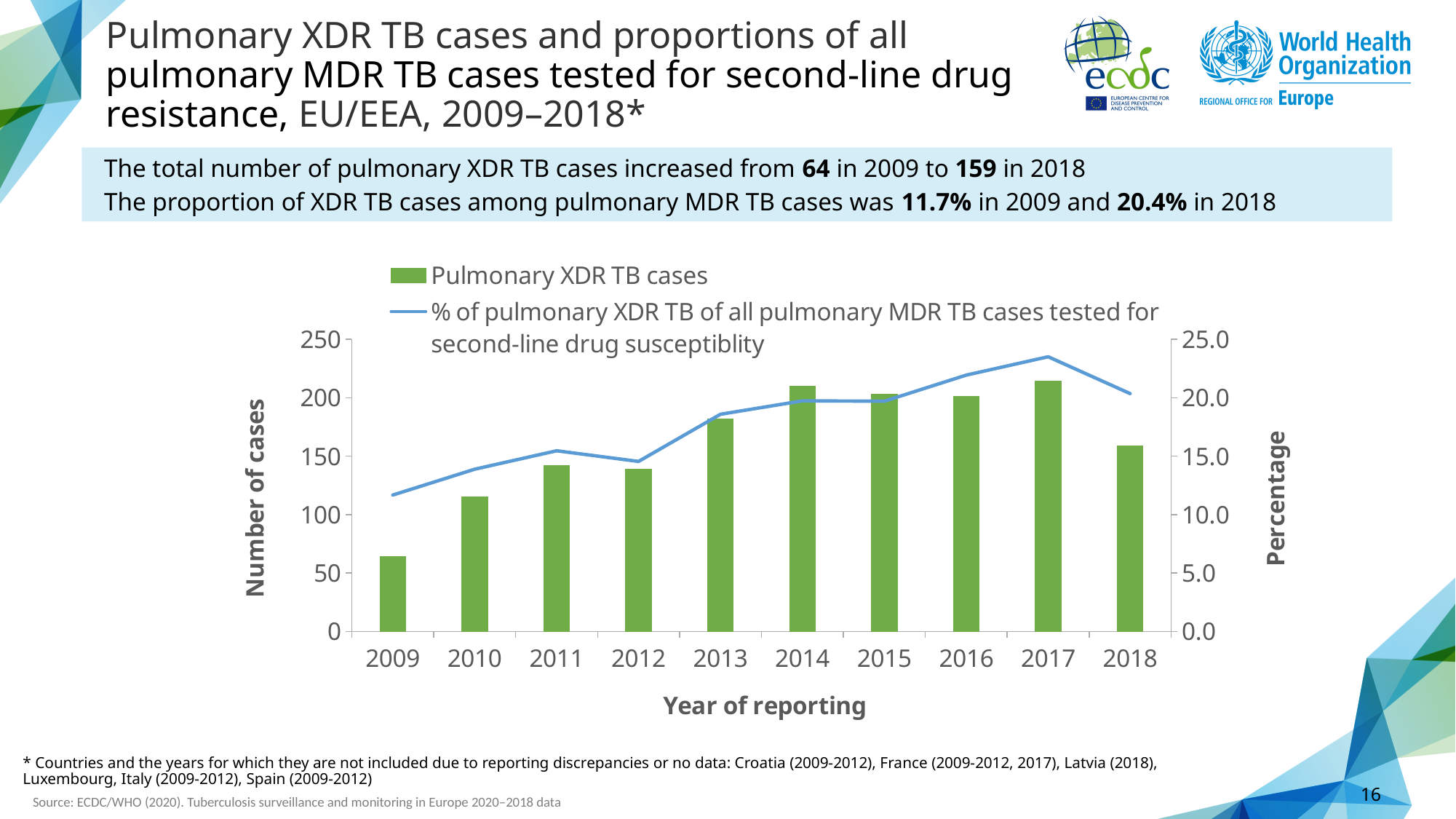
Is the number of pulmonary XDR TB cases in 2012 greater or less than 150? less Is the number of pulmonary XDR TB cases in 2014 greater or less than 200? greater What was the number of pulmonary XDR TB cases in 2018? 159 What was the number of pulmonary XDR TB cases in 2009? 64 Which year has the lowest number of pulmonary XDR TB cases? 2009 In which year does the percentage line reach its highest point? 2017 How many series does the legend list? 2 By how much did the number of pulmonary XDR TB cases increase from 2009 to 2018? 95 What was the percentage of pulmonary XDR TB among pulmonary MDR TB cases tested in 2018? 20.4% How many years of reporting are shown on the x axis? 10 Which year has more pulmonary XDR TB cases, 2013 or 2012? 2013 By how many percentage points did the proportion of XDR TB cases among MDR TB cases change from 2009 to 2018? 8.7